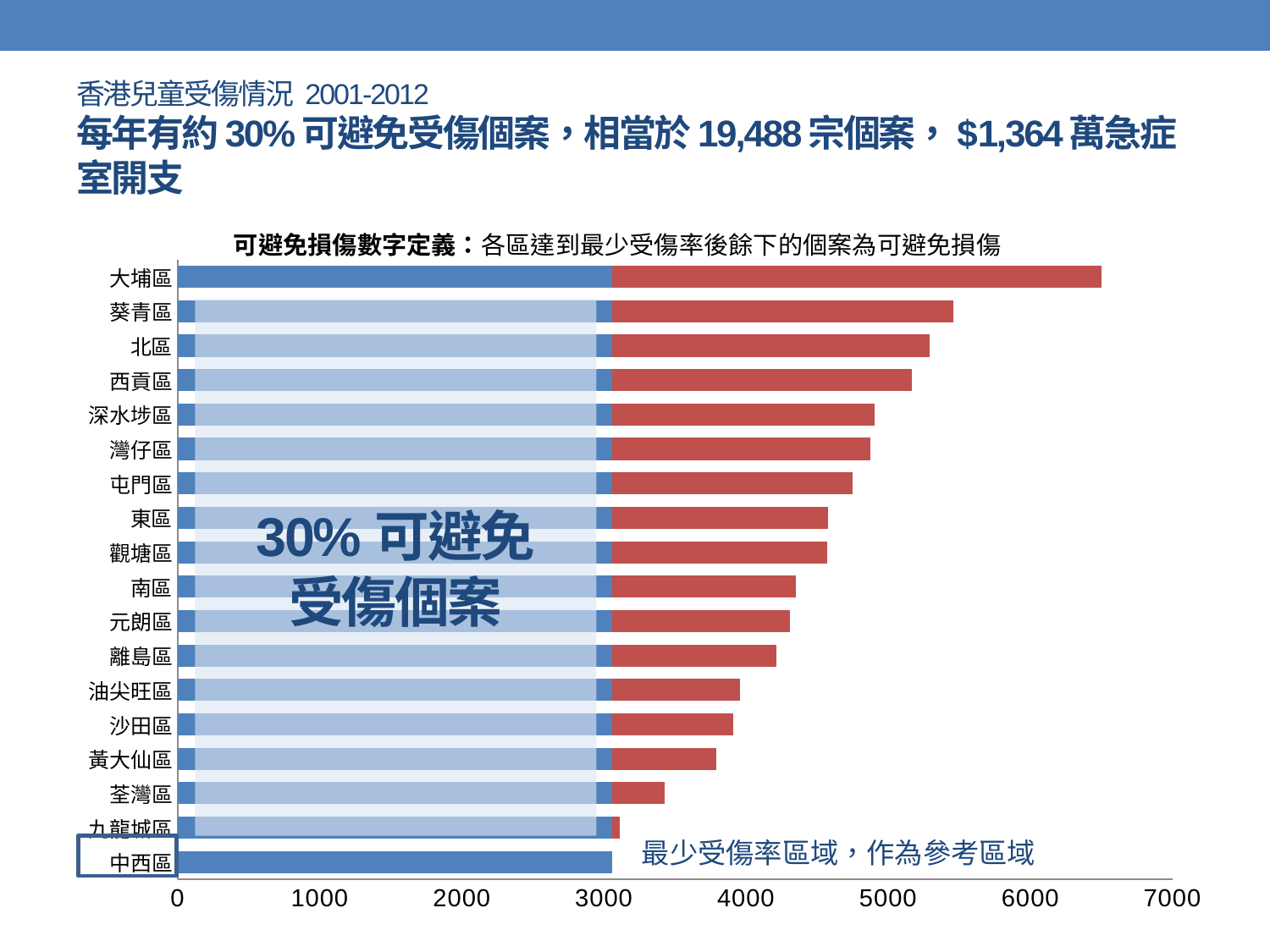
Which district has the longest bar on the chart? 大埔區 Is the total bar length for 荃灣區 greater or less than 4000? less How many districts are listed on the chart? 18 Do the bar lengths increase or decrease going from the top district to the bottom district? decrease Is the total bar length for 黃大仙區 greater or less than 4000? less Is the total bar length for 東區 greater or less than 4000? greater What kind of chart is shown on the slide? Bar chart Which district has a longer bar, 離島區 or 荃灣區? 離島區 Which district has a longer bar, 屯門區 or 南區? 屯門區 What is the highest value shown on the horizontal axis? 7000